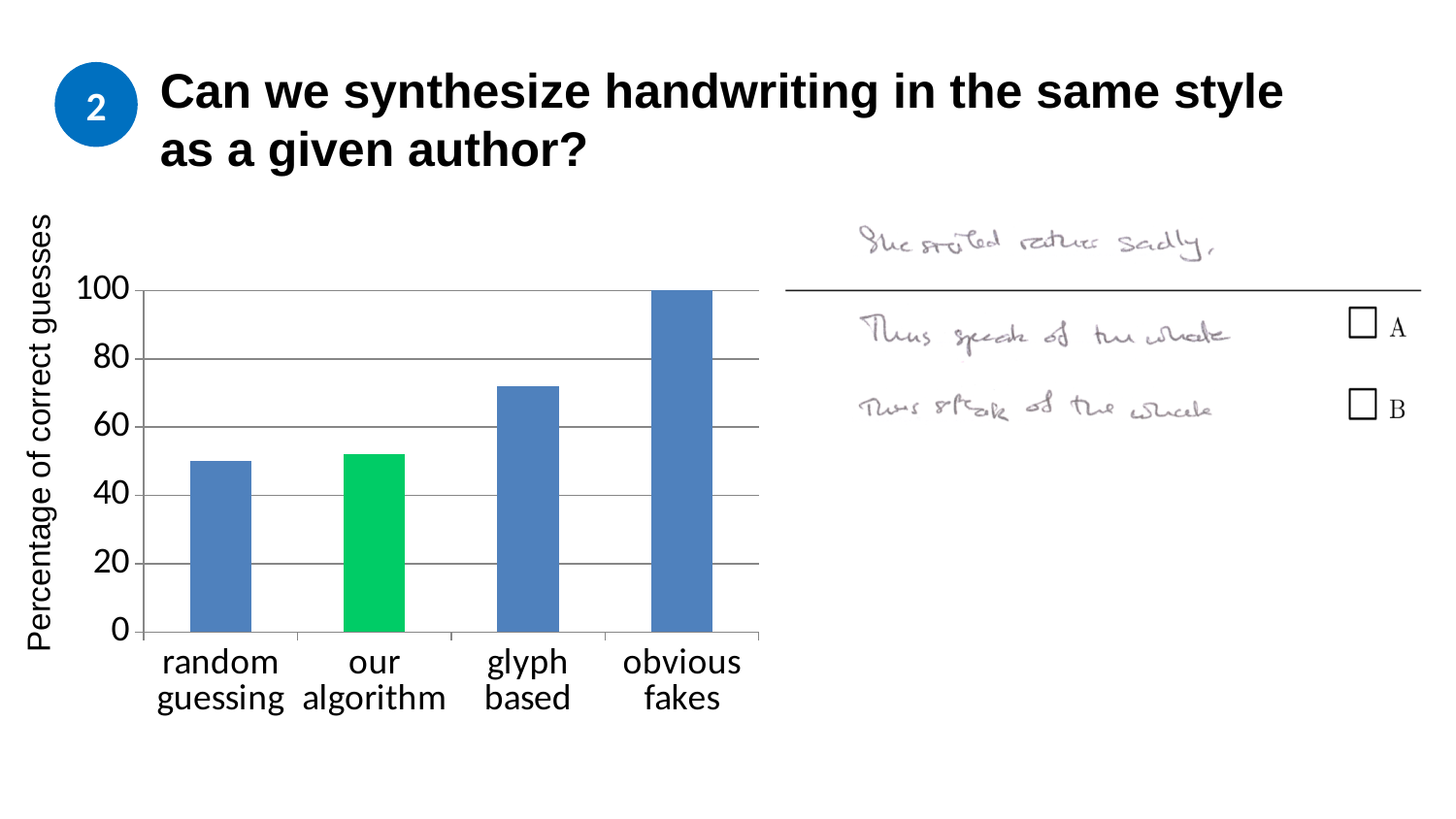
What is the percentage of correct guesses for obvious fakes? 100 Which category's bar is coloured green? our algorithm Is the value for glyph based greater or less than 80? less What is the label of the y axis of the chart? Percentage of correct guesses Is the value for random guessing greater or less than 40? greater Is the value for random guessing greater or less than 60? less Which has a higher percentage of correct guesses, glyph based or our algorithm? glyph based What kind of chart is shown on the slide? bar chart Which category has the highest percentage of correct guesses? obvious fakes How many categories are shown on the x axis of the chart? 4